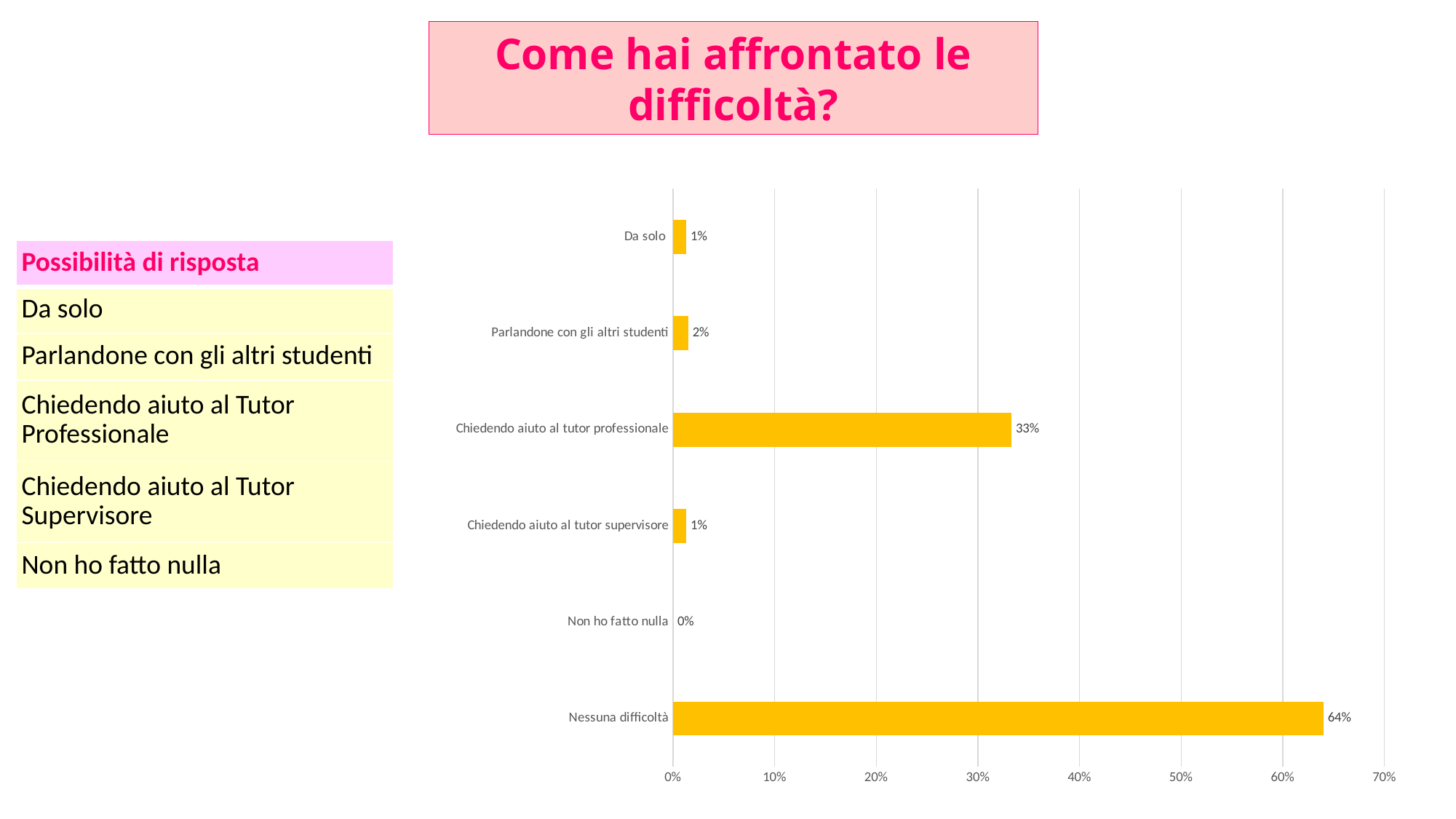
What is the value for "Chiedendo aiuto al tutor professionale"? 33% What is the title shown above the chart? Come hai affrontato le difficoltà? What is the value for "Non ho fatto nulla"? 0% Which is larger, the value for "Parlandone con gli altri studenti" or the value for "Da solo"? Parlandone con gli altri studenti What is the value for "Nessuna difficoltà"? 64% Is the value for "Nessuna difficoltà" greater or less than 60%? greater What kind of chart is shown on the slide? bar chart What is the value for "Parlandone con gli altri studenti"? 2% Which category has the highest value? Nessuna difficoltà What is the difference between the values for "Nessuna difficoltà" and "Chiedendo aiuto al tutor professionale"? 31% Which category has the lowest value? Non ho fatto nulla How many categories are shown in the chart? 6